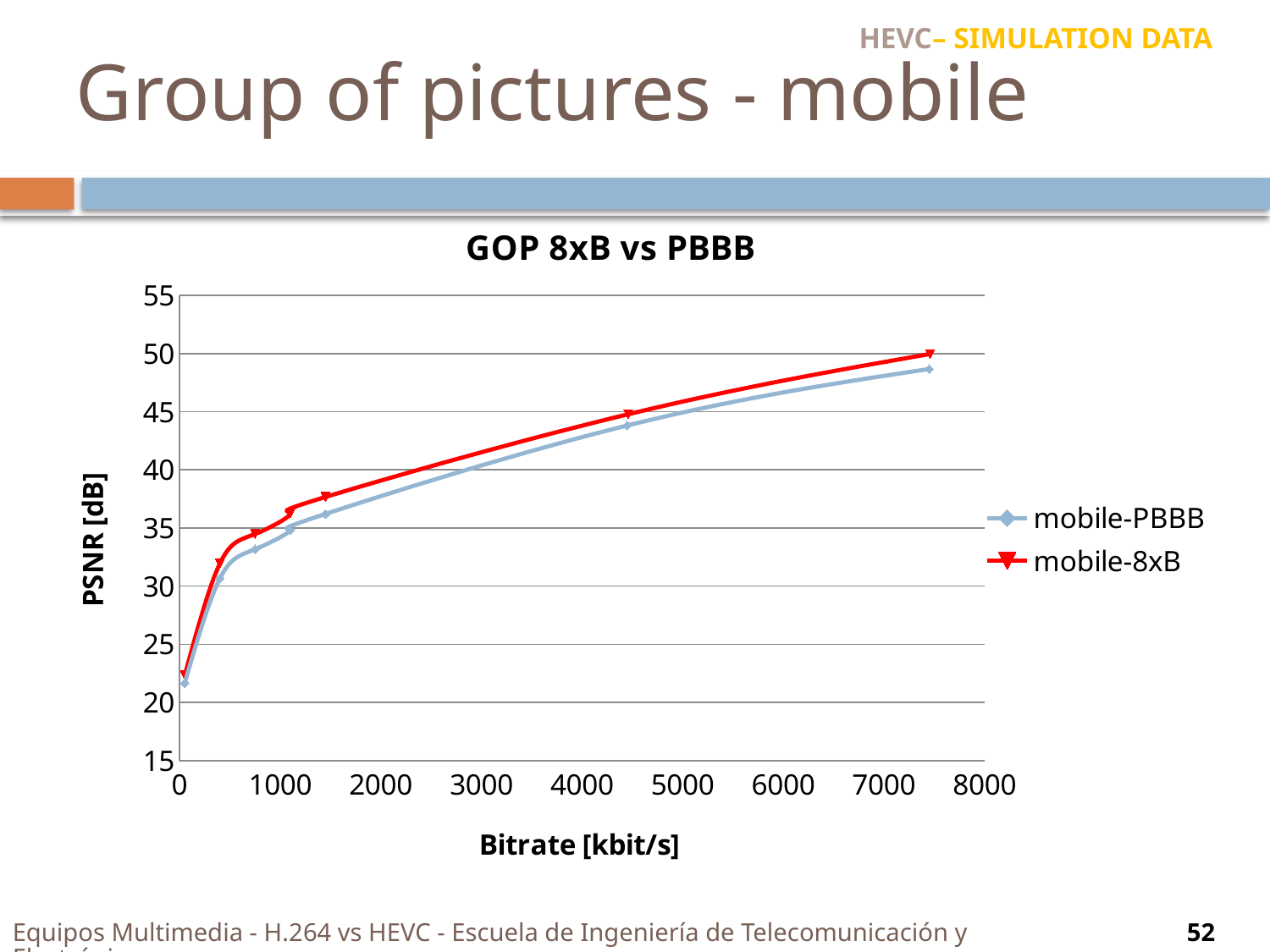
Does PSNR rise or fall as bitrate increases for the mobile-8xB series? rise Is the PSNR of mobile-8xB at its lowest bitrate greater or less than 25? less Is the PSNR of mobile-PBBB at its highest bitrate (about 7500 kbit/s) greater or less than 50? less Which series is drawn in red? mobile-8xB Which series has the higher PSNR at a bitrate of about 1500 kbit/s, mobile-PBBB or mobile-8xB? mobile-8xB Is the PSNR of mobile-PBBB at a bitrate of about 4500 kbit/s greater or less than 45? less Does PSNR rise or fall as bitrate increases for the mobile-PBBB series? rise Which series has the higher PSNR at a bitrate of about 4500 kbit/s, mobile-PBBB or mobile-8xB? mobile-8xB How many series does the legend list? 2 What kind of chart is shown on the slide? line chart What is the title of the chart? GOP 8xB vs PBBB